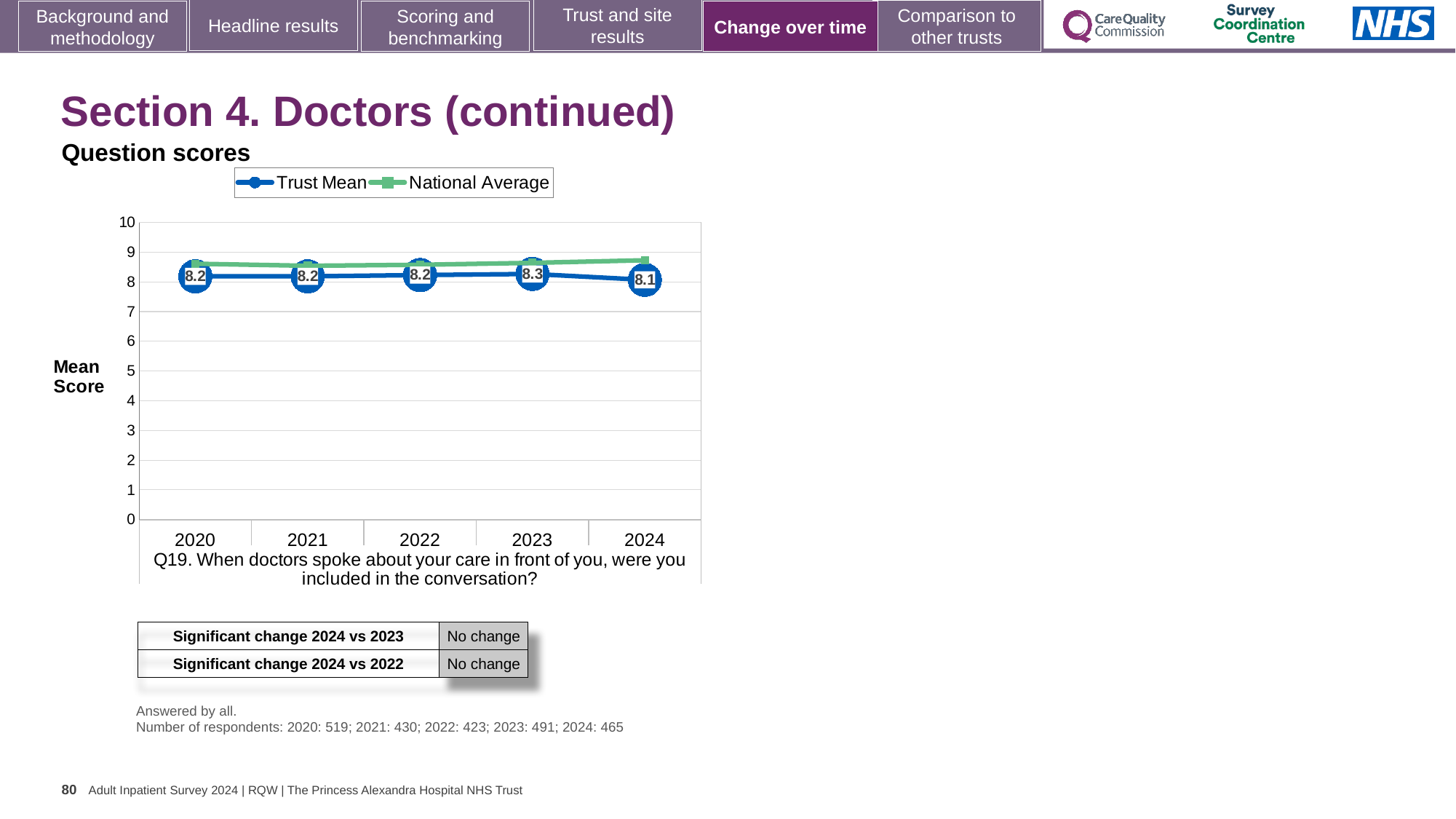
What is the difference between the Trust Mean scores for 2023 and 2024? 0.2 In which year is the Trust Mean score highest? 2023 What kind of chart is shown on the slide? line chart In which year is the Trust Mean score lowest? 2024 What is the Trust Mean score for 2024? 8.1 In 2024, which series has the higher value, Trust Mean or National Average? National Average How many years are shown on the x axis? 5 Does the Trust Mean score rise or fall from 2023 to 2024? fall What is the Trust Mean score for 2023? 8.3 Is the National Average value for 2024 greater or less than 8? greater What is the Trust Mean score for 2020? 8.2 How many series does the legend list? 2